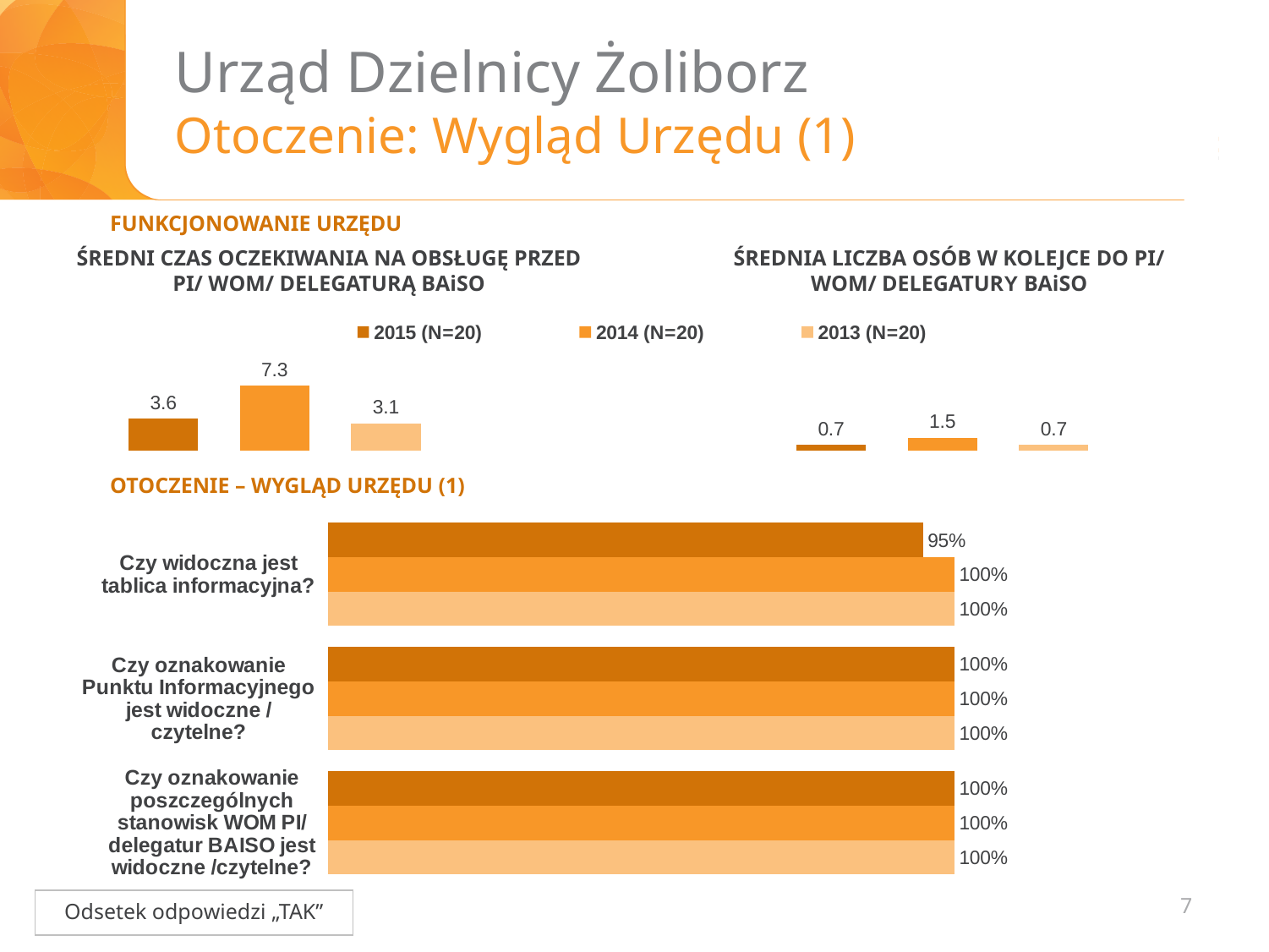
In the chart 'ŚREDNIA LICZBA OSÓB W KOLEJCE DO PI/ WOM/ DELEGATURY BAiSO', which is larger: the value for 2014 or the value for 2015? 2014 In the chart 'ŚREDNIA LICZBA OSÓB W KOLEJCE DO PI/ WOM/ DELEGATURY BAiSO', what is the value for 2013? 0.7 How many question categories are shown in the bottom chart 'OTOCZENIE – WYGLĄD URZĘDU (1)'? 3 How many series does the legend above the top charts list? 3 In the bottom chart 'OTOCZENIE – WYGLĄD URZĘDU (1)', what is the 2015 value for 'Czy widoczna jest tablica informacyjna?'? 95% In the bottom chart 'OTOCZENIE – WYGLĄD URZĘDU (1)', what is the 2014 value for 'Czy oznakowanie Punktu Informacyjnego jest widoczne / czytelne?'? 100% In the chart 'ŚREDNI CZAS OCZEKIWANIA NA OBSŁUGĘ PRZED PI/ WOM/ DELEGATURĄ BAiSO', what is the value for 2015? 3.6 In the chart 'ŚREDNI CZAS OCZEKIWANIA NA OBSŁUGĘ PRZED PI/ WOM/ DELEGATURĄ BAiSO', what is the difference between the 2014 and 2015 values? 3.7 In the chart 'ŚREDNIA LICZBA OSÓB W KOLEJCE DO PI/ WOM/ DELEGATURY BAiSO', what is the value for 2014? 1.5 What type of chart is the bottom chart 'OTOCZENIE – WYGLĄD URZĘDU (1)'? Bar chart In the chart 'ŚREDNI CZAS OCZEKIWANIA NA OBSŁUGĘ PRZED PI/ WOM/ DELEGATURĄ BAiSO', which year has the highest value? 2014 In the chart 'ŚREDNI CZAS OCZEKIWANIA NA OBSŁUGĘ PRZED PI/ WOM/ DELEGATURĄ BAiSO', which year has the lowest value? 2013